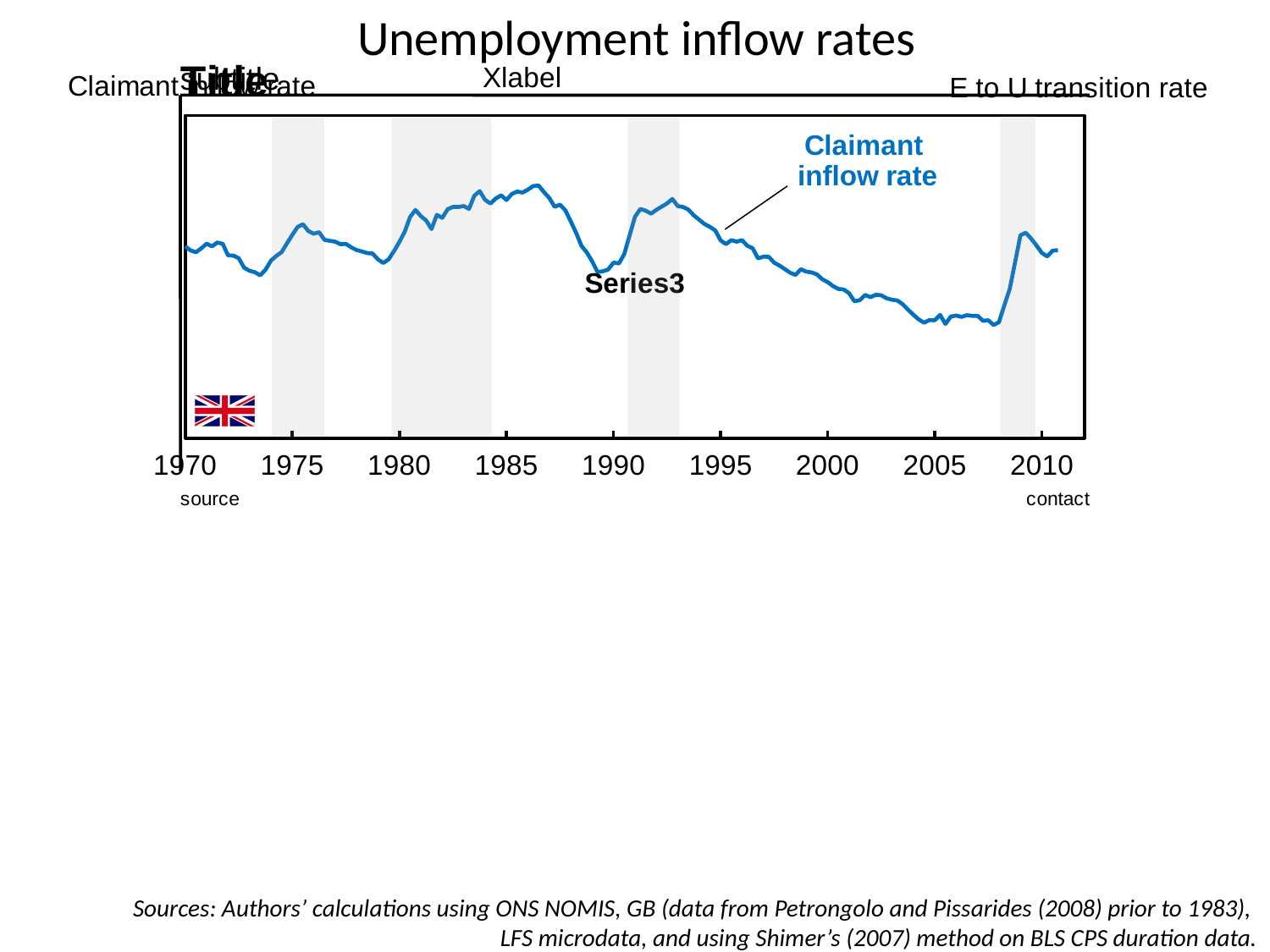
What label is attached to the blue line in the chart? Claimant inflow rate Does the claimant inflow rate rise or fall between 1995 and 2005? fall How many year labels are shown on the x axis? 9 What kind of chart is shown on the slide? line chart Does the claimant inflow rate rise or fall between 1979 and 1986? rise What is the title of the chart? Unemployment inflow rates Around which year does the claimant inflow rate reach its highest point? 1986 Is the claimant inflow rate higher around 1986 or around 2005? around 1986 Is the claimant inflow rate higher around 1975 or around 2000? around 1975 In which decade does the claimant inflow rate reach its lowest point? 2000s What is the first year labelled on the x axis? 1970 What is the last year labelled on the x axis? 2010